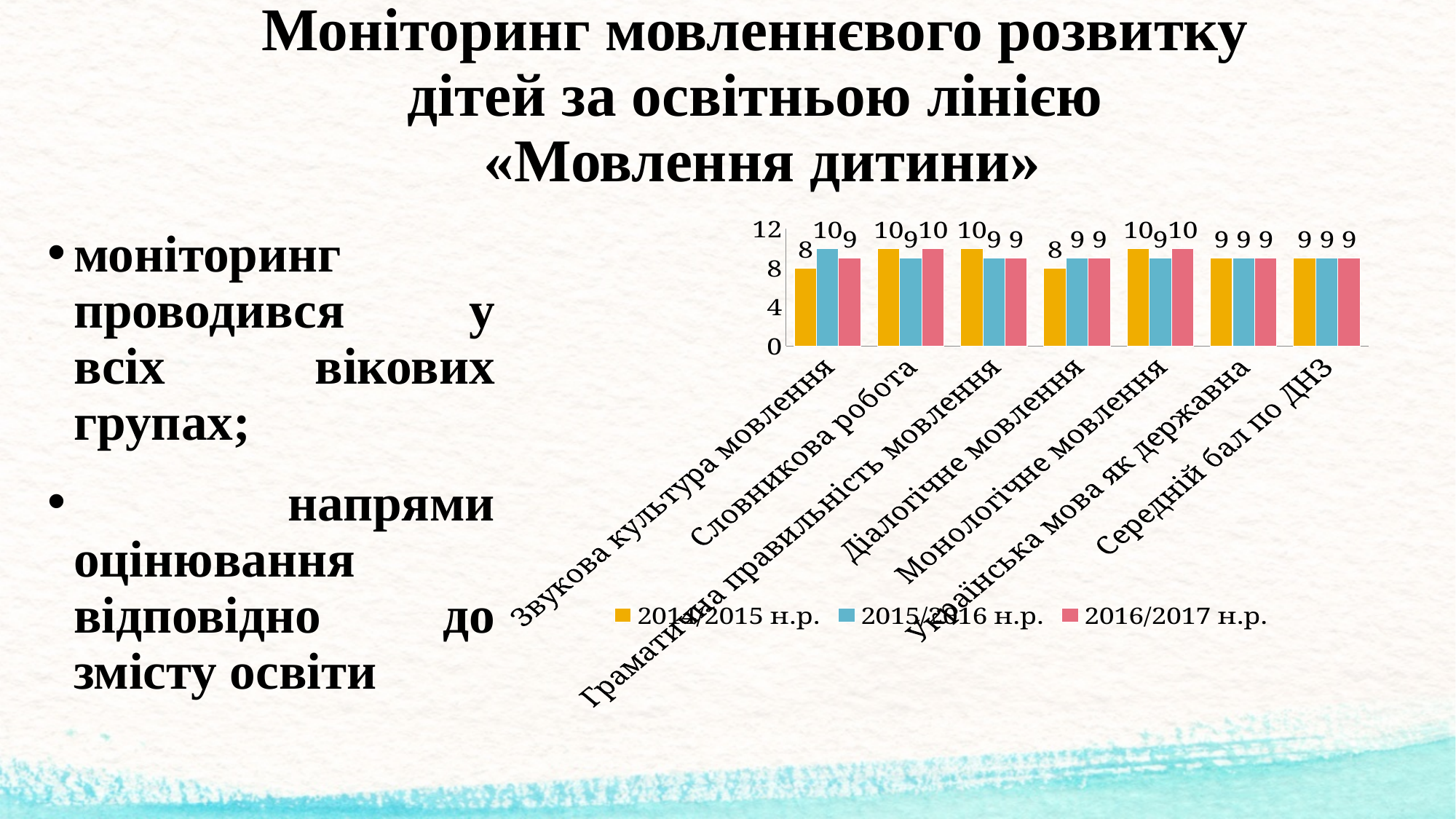
What is the value for Звукова культура мовлення in 2014/2015 н.р.? 8 What is the value for Звукова культура мовлення in 2015/2016 н.р.? 10 How many series does the chart legend list? 3 What is the difference between the 2015/2016 н.р. and 2014/2015 н.р. values for Звукова культура мовлення? 2 What is the value for Діалогічне мовлення in 2016/2017 н.р.? 9 What type of chart is shown on the slide? bar chart How many categories are shown on the x axis of the chart? 7 Which category has the lowest value in the 2014/2015 н.р. series? Звукова культура мовлення and Діалогічне мовлення Which is larger for Словникова робота: the 2014/2015 н.р. value or the 2015/2016 н.р. value? 2014/2015 н.р. Which series is shown in red in the chart legend? 2016/2017 н.р. What is the value for Монологічне мовлення in 2014/2015 н.р.? 10 What is the value for Середній бал по ДНЗ in 2016/2017 н.р.? 9